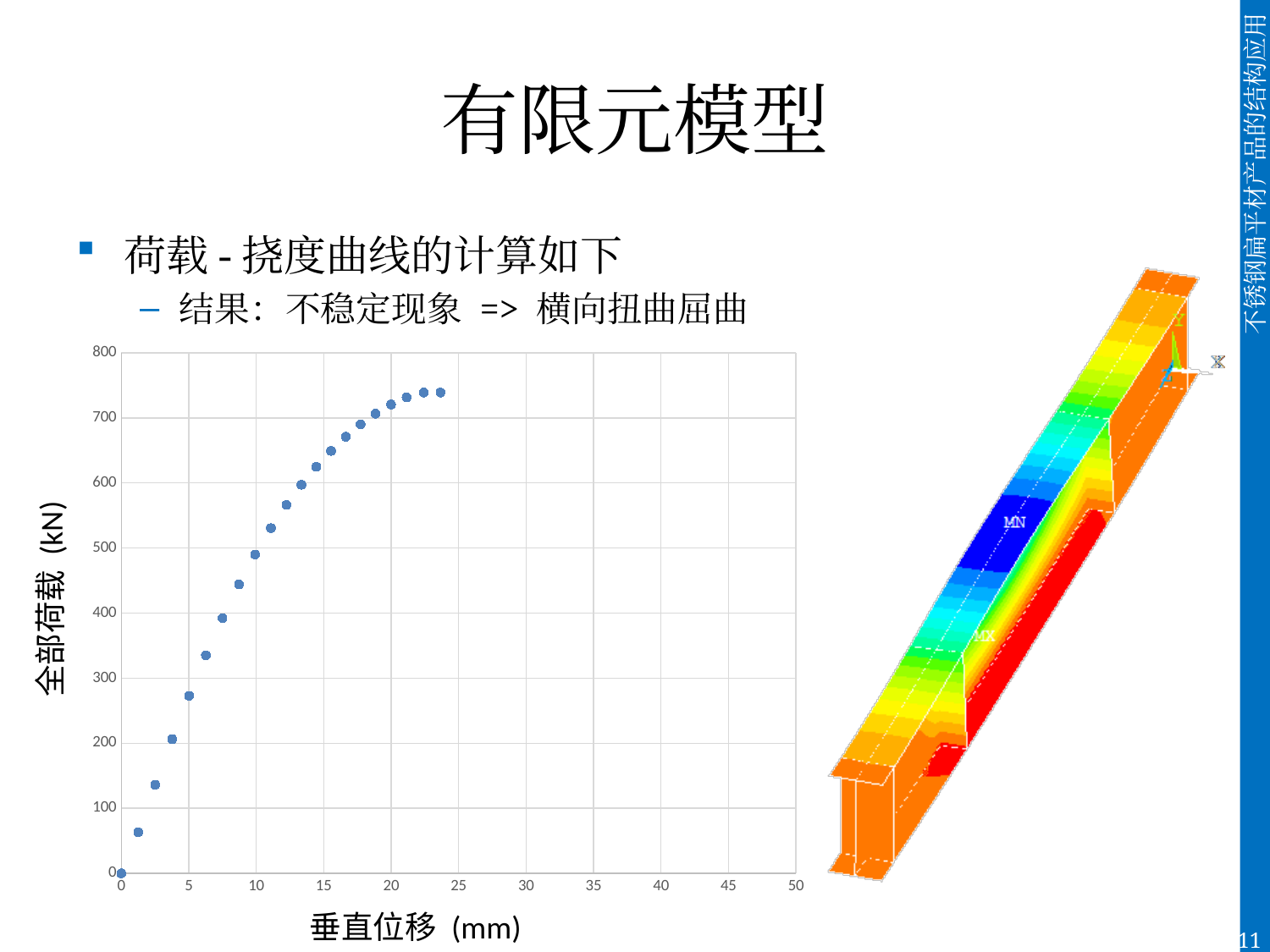
Does the load rise or fall as the vertical displacement increases along the x axis? rise What is the maximum value shown on the x axis of the chart? 50 What is the title of the y axis of the chart? 全部荷载 (kN) Is the load at a vertical displacement of 5 mm greater or less than 300 kN? less Is the highest load reached in the chart greater or less than 800 kN? less What is the title of the x axis of the chart? 垂直位移 (mm) Is the load at a vertical displacement of 15 mm greater or less than 600 kN? greater What kind of chart is shown on the slide? scatter chart